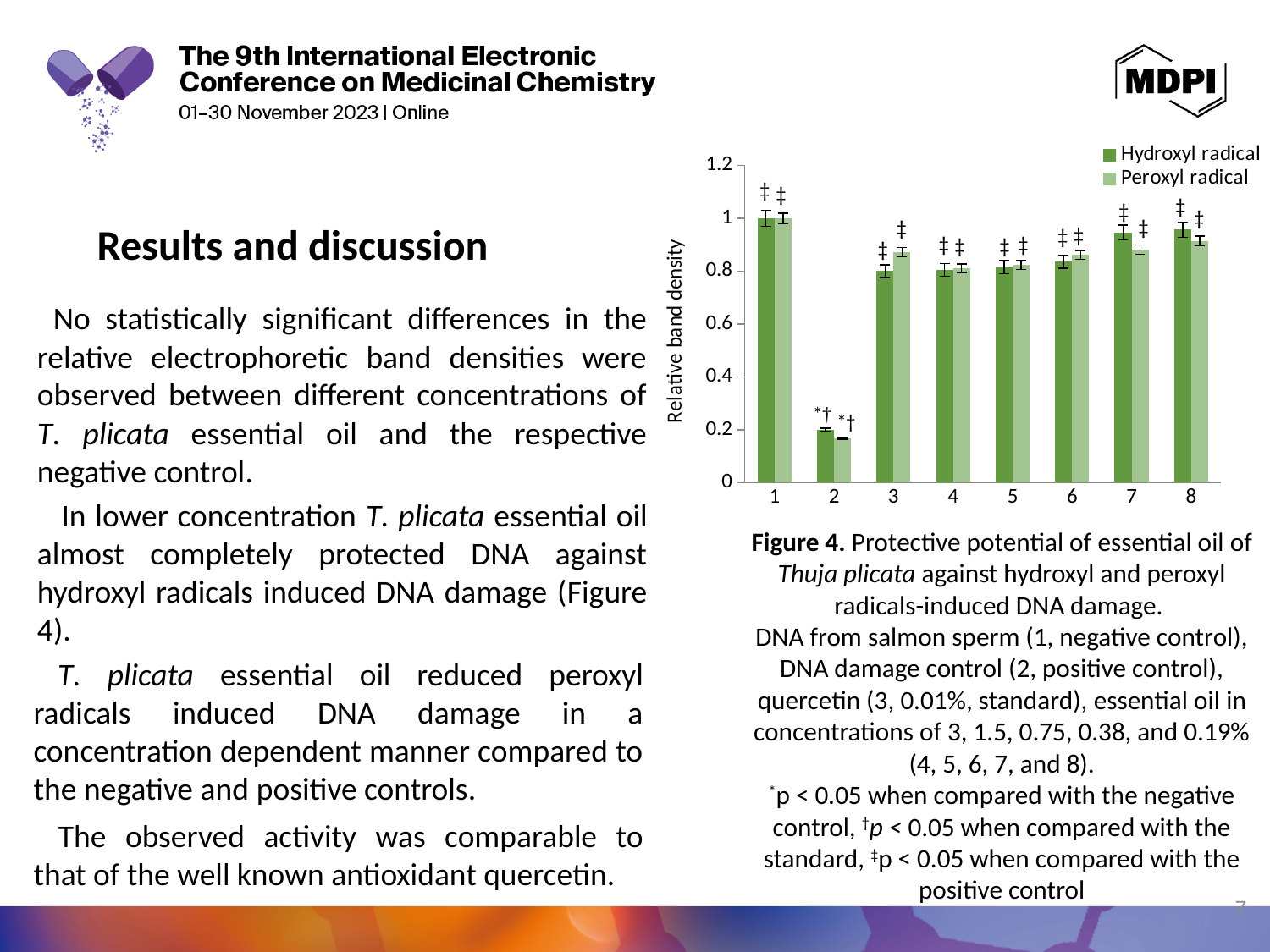
Which is larger for the Hydroxyl radical series: category 1 or category 4? category 1 What is the relative band density for the Hydroxyl radical series in category 1? 1 Which is larger in category 2: the Hydroxyl radical value or the Peroxyl radical value? Hydroxyl radical Which category has the highest relative band density for the Peroxyl radical series? 1 How many series does the chart legend list? 2 Is the Peroxyl radical value for category 3 greater or less than 0.8? greater What are the two series named in the chart legend? Hydroxyl radical and Peroxyl radical What kind of chart is shown on the slide? bar chart Which category has the lowest relative band density for the Hydroxyl radical series? 2 Is the Hydroxyl radical value for category 2 greater or less than 0.4? less What is the label of the y axis of the chart? Relative band density How many categories are shown along the x axis of the chart? 8